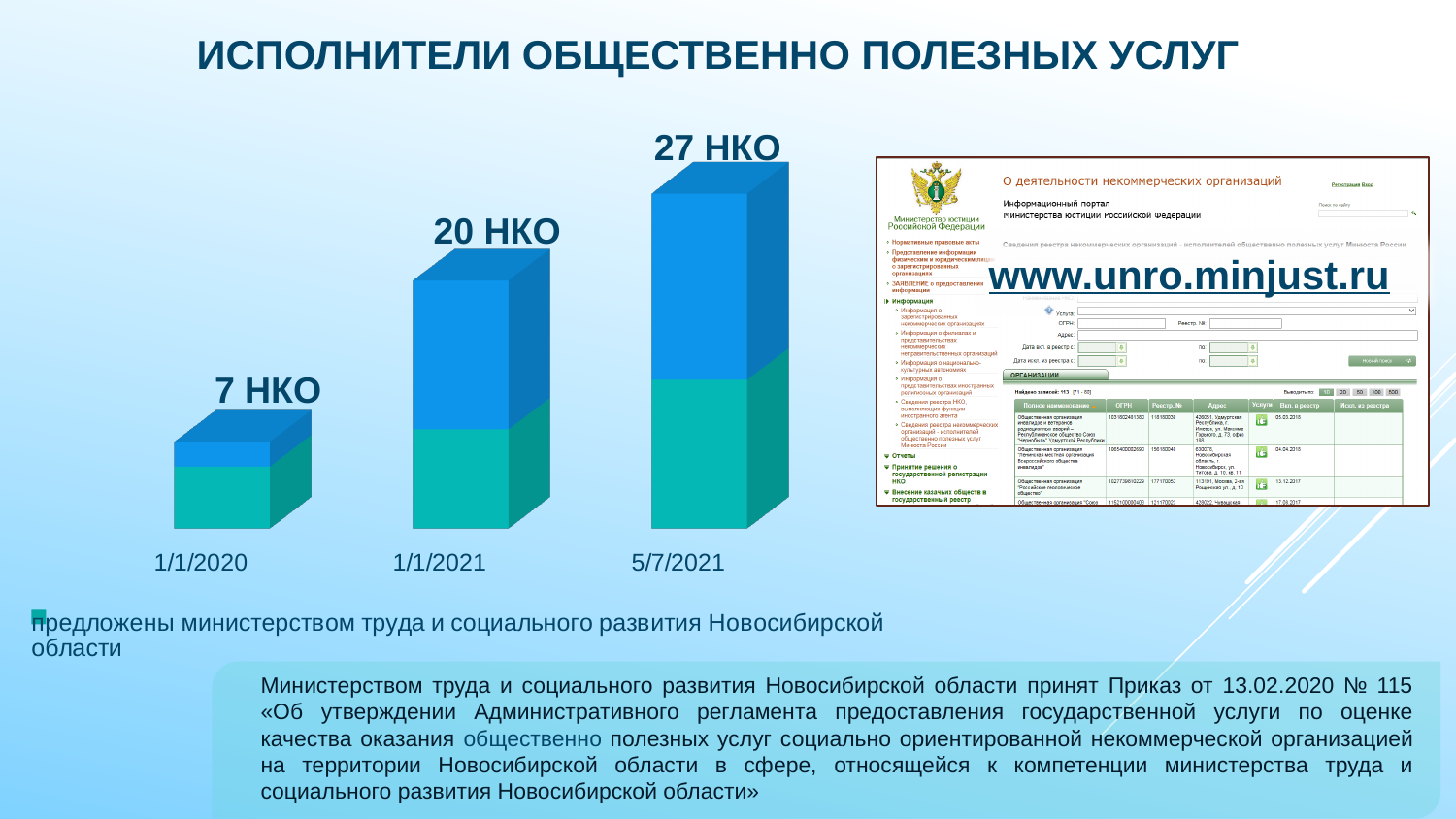
What is the difference between the values for 5/7/2021 and 1/1/2021? 7 НКО Which is larger, the value for 1/1/2021 or the value for 1/1/2020? 1/1/2021 What kind of chart is shown on the slide? bar chart What value is shown for 5/7/2021? 27 НКО What value is shown for 1/1/2021? 20 НКО Which date has the lowest value? 1/1/2020 How many dates (bars) are shown in the chart? 3 Do the values rise or fall from 1/1/2020 to 5/7/2021? rise What value is shown for 1/1/2020? 7 НКО What is the title of the slide containing the chart? ИСПОЛНИТЕЛИ ОБЩЕСТВЕННО ПОЛЕЗНЫХ УСЛУГ What is the difference between the values for 1/1/2021 and 1/1/2020? 13 НКО Which date has the highest value? 5/7/2021